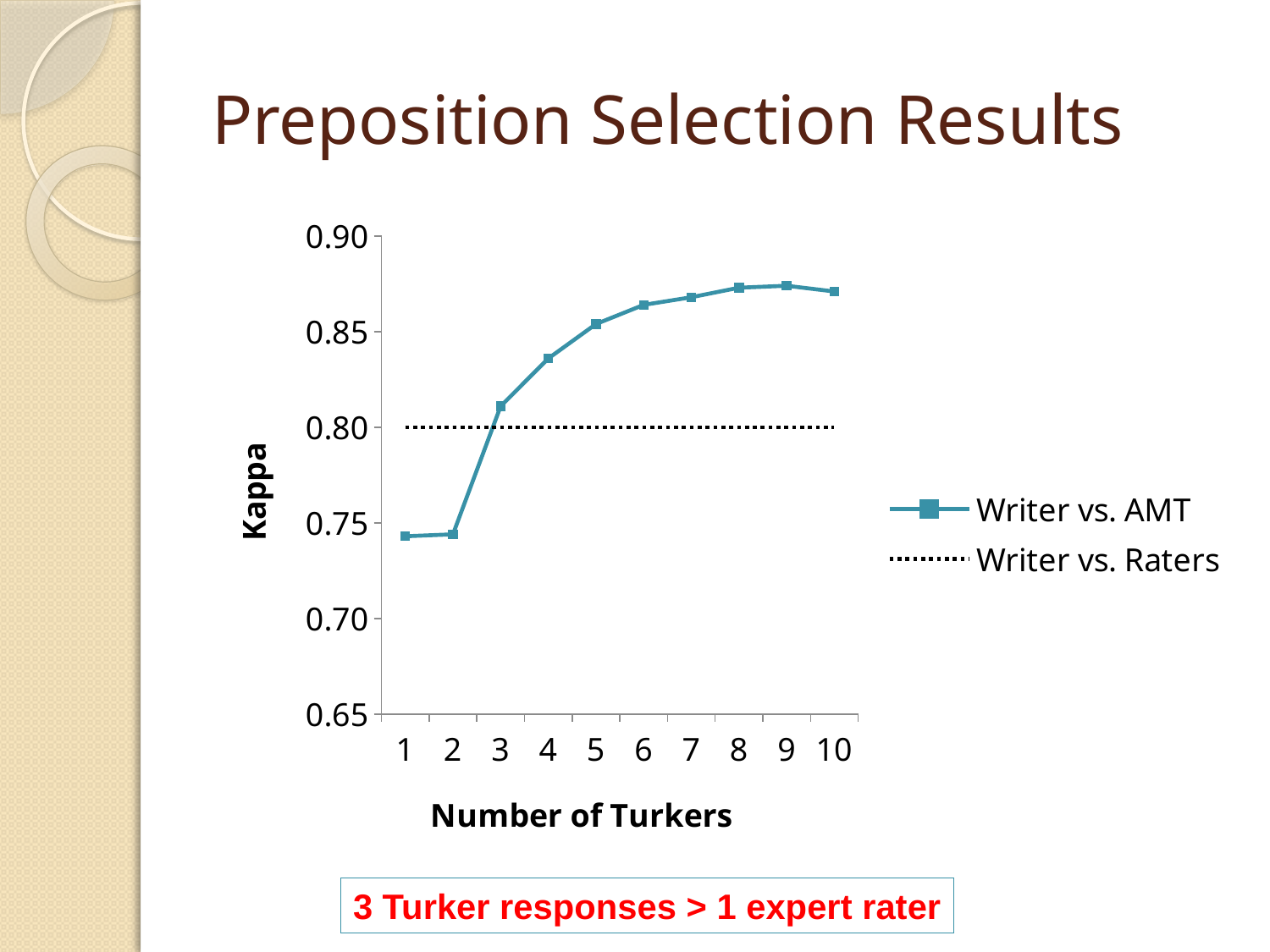
Is the Writer vs. AMT kappa for 3 Turkers greater or less than 0.80? greater Is the Writer vs. AMT kappa for 4 Turkers greater or less than 0.85? less Which is larger, the Writer vs. AMT kappa for 2 Turkers or for 3 Turkers? 3 Turkers Is the Writer vs. AMT kappa for 1 Turker greater or less than 0.75? less What kind of chart is shown on the slide? line chart Does the Writer vs. AMT kappa generally rise or fall as the number of Turkers increases from 1 to 9? rise What is the label of the x axis? Number of Turkers How many series does the legend list? 2 What is the label of the y axis? Kappa How many points are plotted for the Writer vs. AMT series? 10